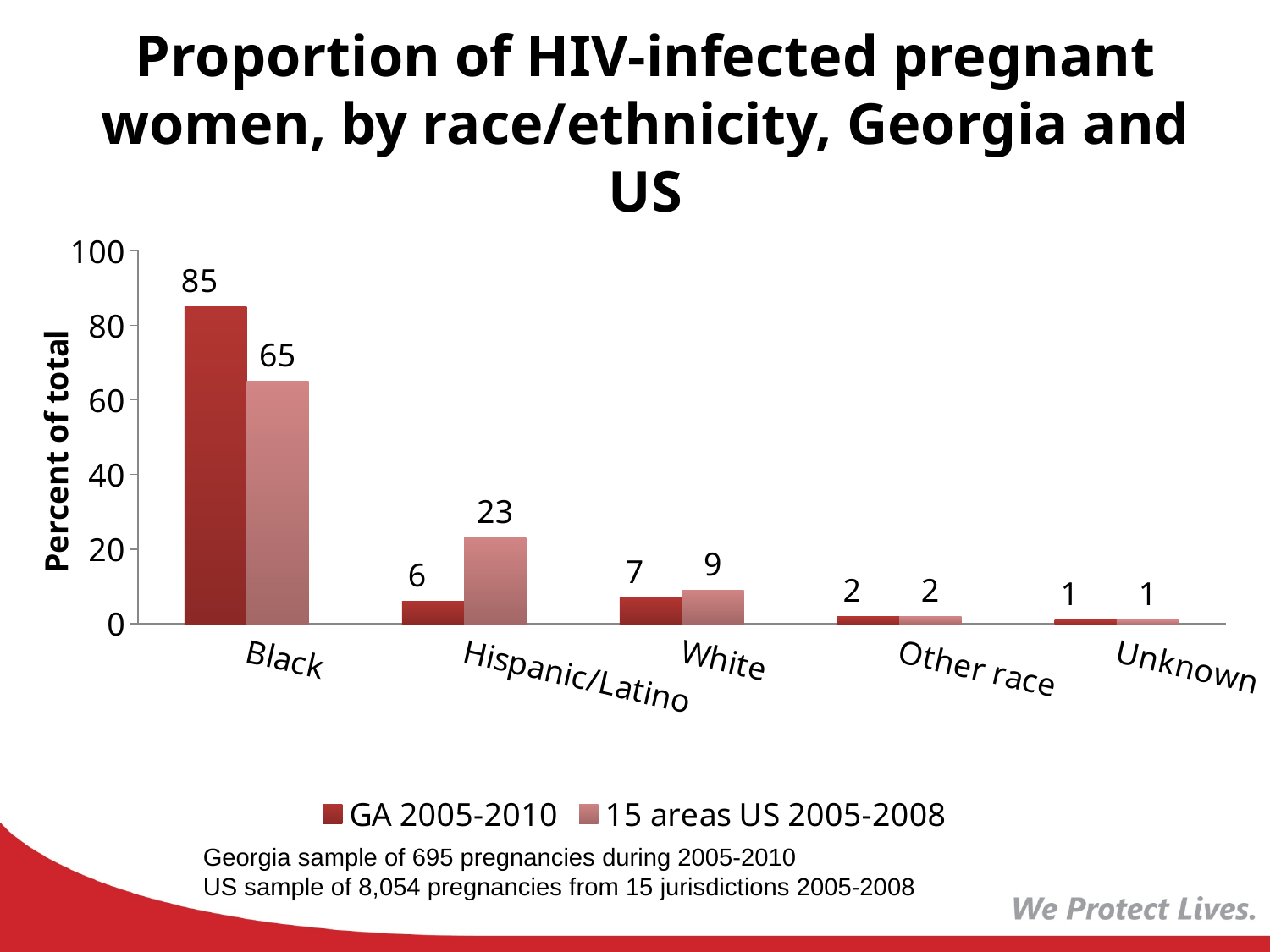
What kind of chart is shown on the slide? Bar chart What is the value for White in the GA 2005-2010 series? 7 Which category has the highest value in the GA 2005-2010 series? Black For Hispanic/Latino, which series has the larger value: GA 2005-2010 or 15 areas US 2005-2008? 15 areas US 2005-2008 Which category has the lowest value in the 15 areas US 2005-2008 series? Unknown What is the difference between the GA 2005-2010 and 15 areas US 2005-2008 values for Black? 20 What is the value for Black in the GA 2005-2010 series? 85 What is the value for Hispanic/Latino in the 15 areas US 2005-2008 series? 23 What is the label of the y axis? Percent of total How many series does the legend list? 2 Is the value for Black in the 15 areas US 2005-2008 series greater or less than 60? greater How many race/ethnicity categories are shown on the x axis? 5